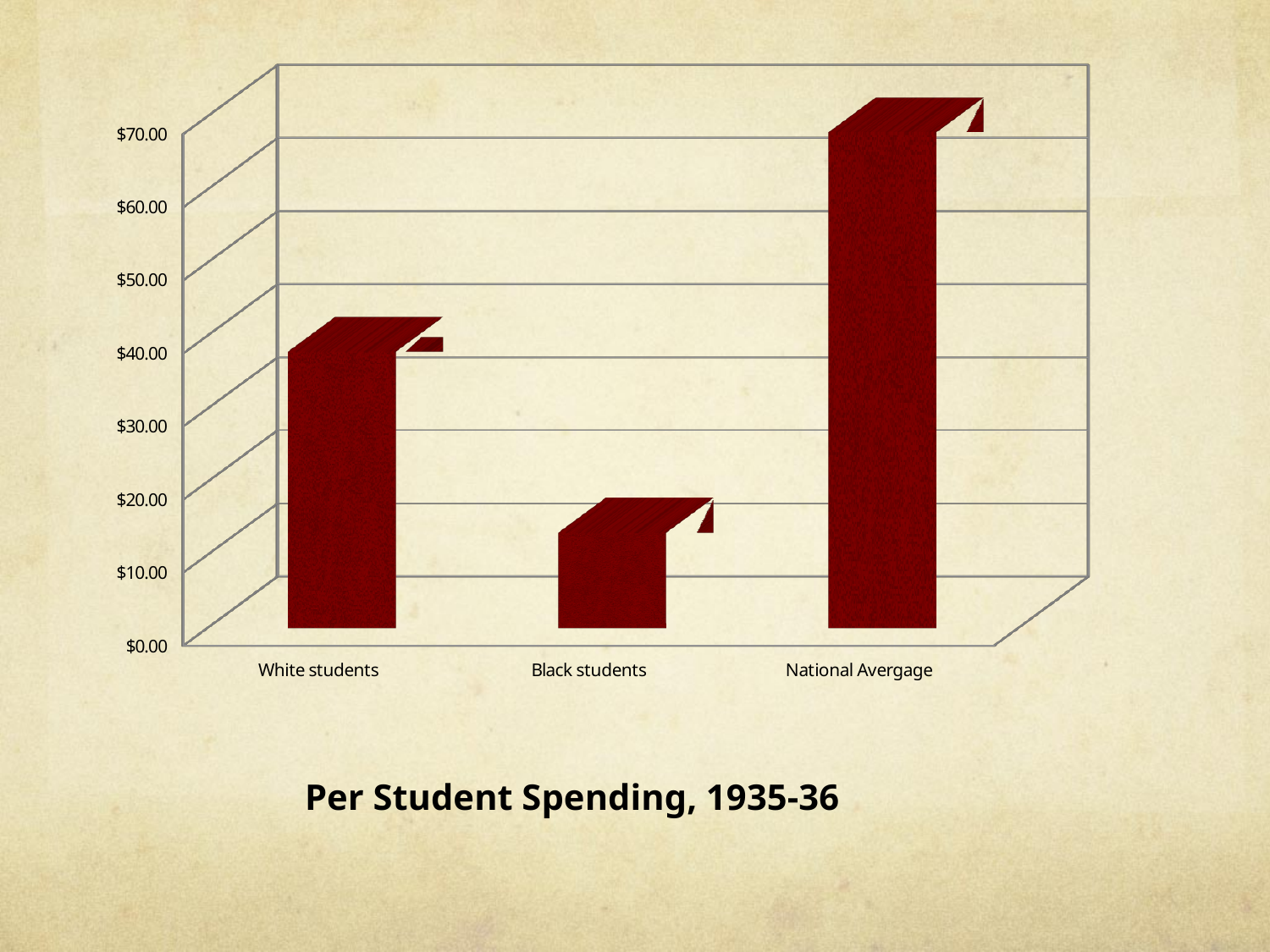
What kind of chart is shown on the slide? Bar chart Is the value for Black students greater or less than $20.00? less Which is larger, the value for National Avergage or the value for White students? National Avergage How many categories are shown on the x axis? 3 Which category has the highest per student spending? National Avergage What colour are the bars in the chart? Dark red Which is larger, the value for White students or the value for Black students? White students What is the title of the chart? Per Student Spending, 1935-36 Is the value for White students greater or less than $50.00? less Which category has the lowest per student spending? Black students Is the value for National Avergage greater or less than $60.00? greater